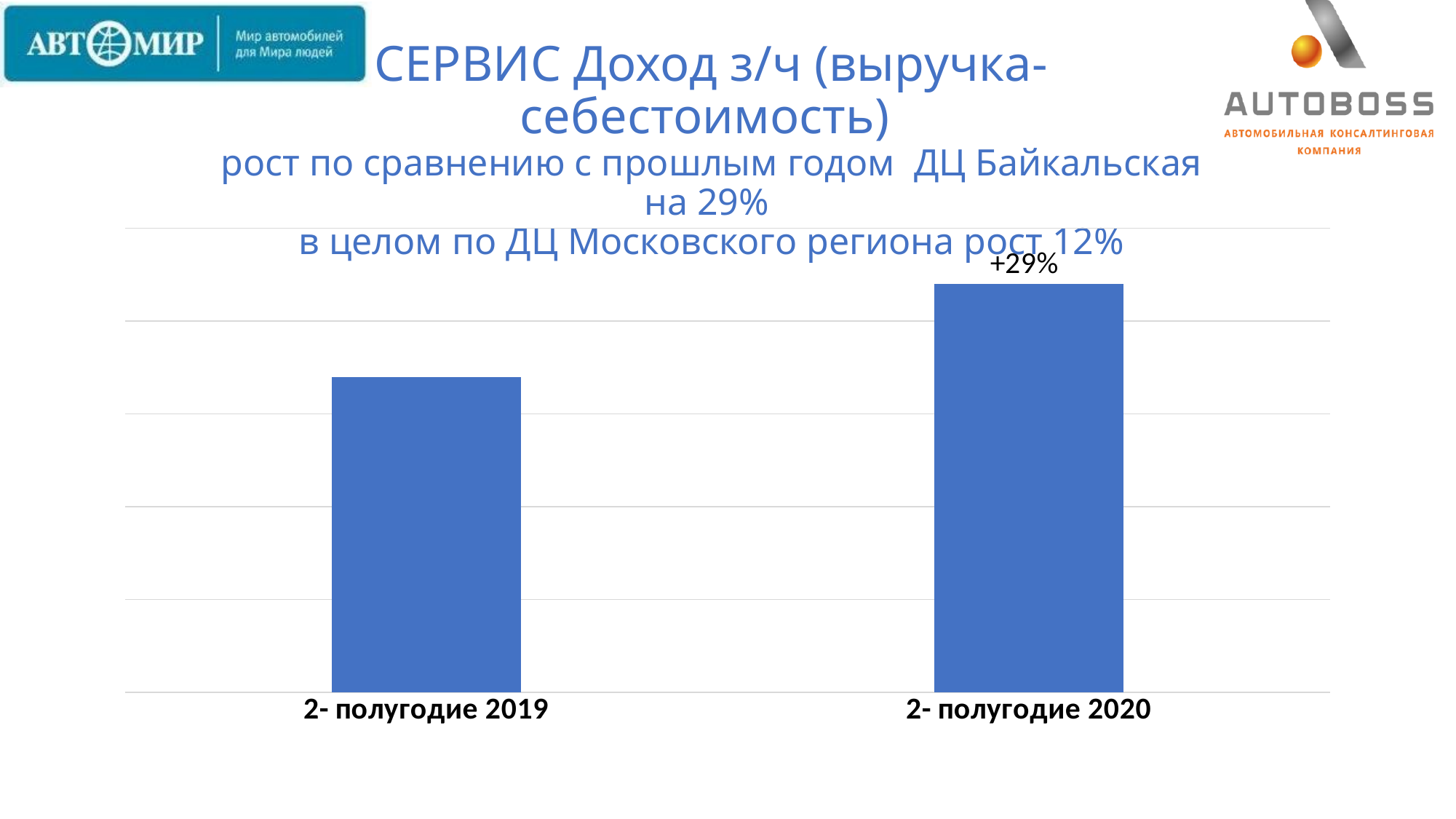
How many bars are plotted in the chart? 2 Which category has the highest bar? 2- полугодие 2020 Which category has the lowest bar? 2- полугодие 2019 What are the two category labels on the x axis of the chart? 2- полугодие 2019, 2- полугодие 2020 What kind of chart is shown on the slide? bar chart Which is larger, the bar for 2- полугодие 2019 or the bar for 2- полугодие 2020? 2- полугодие 2020 What data label is printed above the bar for 2- полугодие 2020? +29% What colour are the bars in the chart? blue By what percentage did the value grow compared to the previous year according to the label on the chart? +29% Do the values rise or fall from 2- полугодие 2019 to 2- полугодие 2020? rise